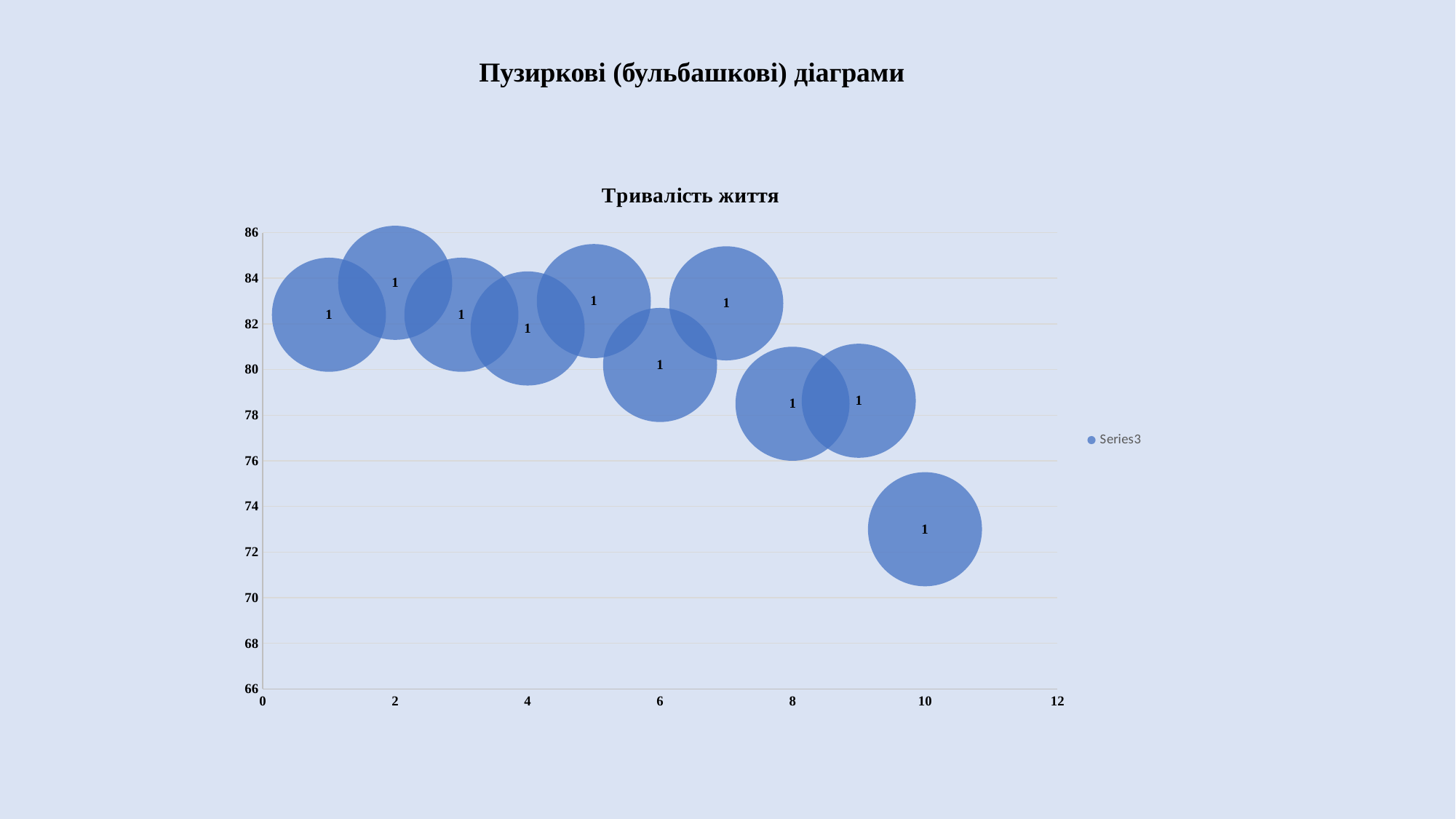
Is the value for the bubble at x = 2 greater or less than 82? greater Is the value for the bubble at x = 8 greater or less than 80? less What kind of chart is shown on the slide? bubble chart How many bubbles are plotted on the chart? 10 Which bubble has the larger value, the one at x = 7 or the one at x = 8? x = 7 What is the name of the series shown in the legend? Series3 Do the bubble values generally rise or fall as x increases? fall What is the title of the chart? Тривалість життя At which x value is the lowest bubble on the chart? 10 What data label is printed on the bubble at x = 10? 1 Is the value for the bubble at x = 10 greater or less than 74? less How many series does the legend list? 1